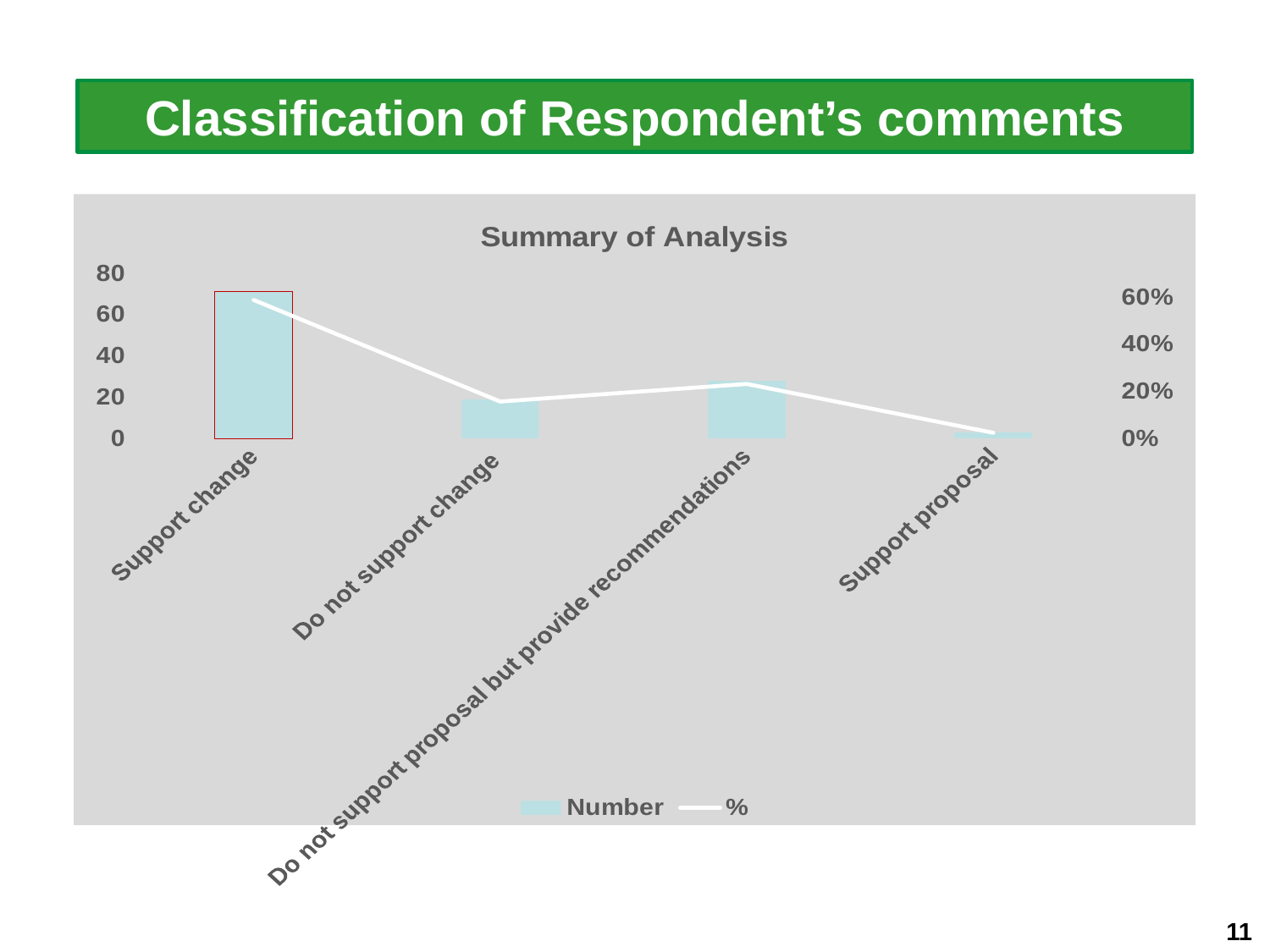
How many series does the chart's legend list? 2 What are the two series named in the chart's legend? Number and % How many categories are shown on the x axis of the chart? 4 Which category has the lowest Number bar? Support proposal Is the Number bar for Support change greater or less than 60? greater Is the Number bar for Do not support proposal but provide recommendations greater or less than 40? less Is the % value for Support change greater or less than 40%? greater Which category has the highest Number bar? Support change What is the title of the chart? Summary of Analysis Does the % line rise or fall between Do not support proposal but provide recommendations and Support proposal? fall Which has the larger Number bar: Do not support change or Do not support proposal but provide recommendations? Do not support proposal but provide recommendations